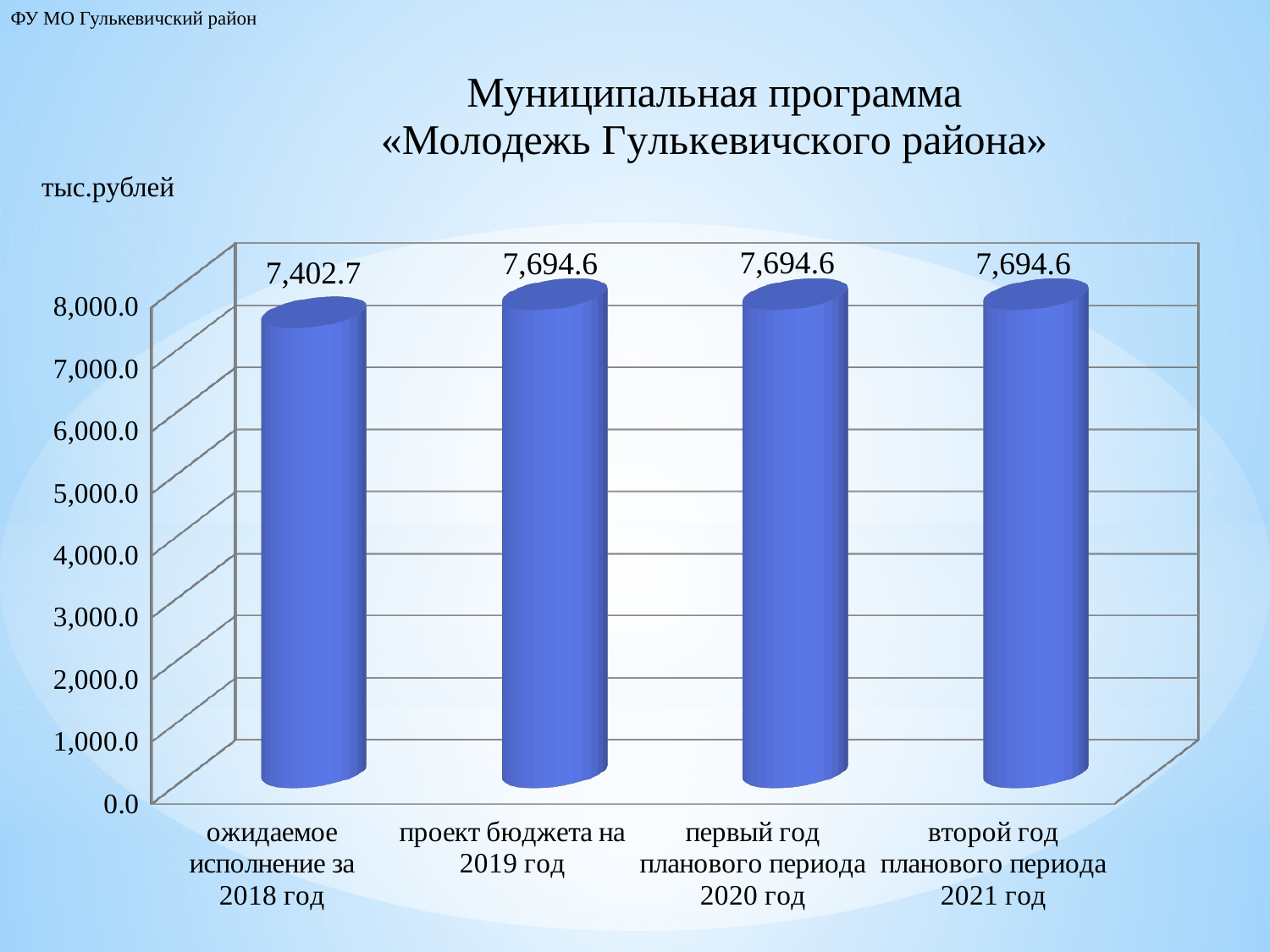
What is the value for "второй год планового периода 2021 год"? 7,694.6 Is the value for "проект бюджета на 2019 год" greater or less than 8,000.0? less Which category has the lowest value? ожидаемое исполнение за 2018 год What is the value for "проект бюджета на 2019 год"? 7,694.6 How many categories are shown on the chart? 4 What is the title of the chart? Муниципальная программа «Молодежь Гулькевичского района» What unit is indicated for the values on the chart? тыс.рублей Is the value for "ожидаемое исполнение за 2018 год" greater or less than 7,000.0? greater What kind of chart is shown on the slide? bar chart What is the value for "ожидаемое исполнение за 2018 год"? 7,402.7 What is the difference between the value for "проект бюджета на 2019 год" and the value for "ожидаемое исполнение за 2018 год"? 291.9 Which is larger: the value for "ожидаемое исполнение за 2018 год" or the value for "первый год планового периода 2020 год"? первый год планового периода 2020 год